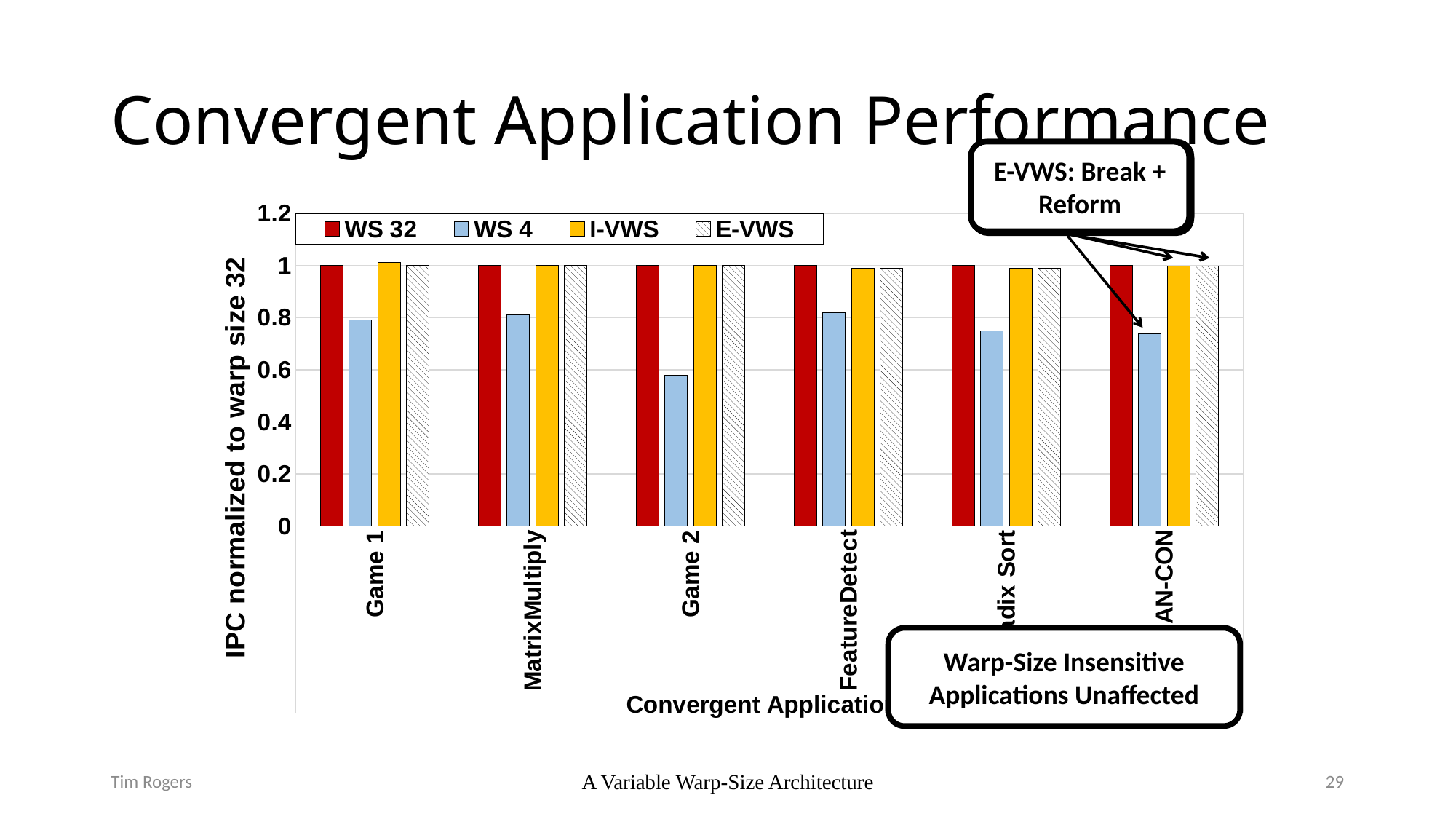
What kind of chart is shown on the slide? bar chart Which application has the lowest WS 4 value? Game 2 Is the WS 4 value for Game 1 greater or less than 0.6? greater How many series does the legend list? 4 Which is larger: the WS 4 value for Game 1 or the WS 4 value for Game 2? Game 1 Which is larger for Game 2: the WS 32 value or the WS 4 value? WS 32 What is the title of the y axis? IPC normalized to warp size 32 Is the WS 4 value for FeatureDetect greater or less than 0.6? greater How many application categories are plotted along the x axis? 6 Is the WS 4 value for Game 2 greater or less than 0.4? greater What is the WS 32 value for Game 1? 1 What is the WS 32 value for MatrixMultiply? 1